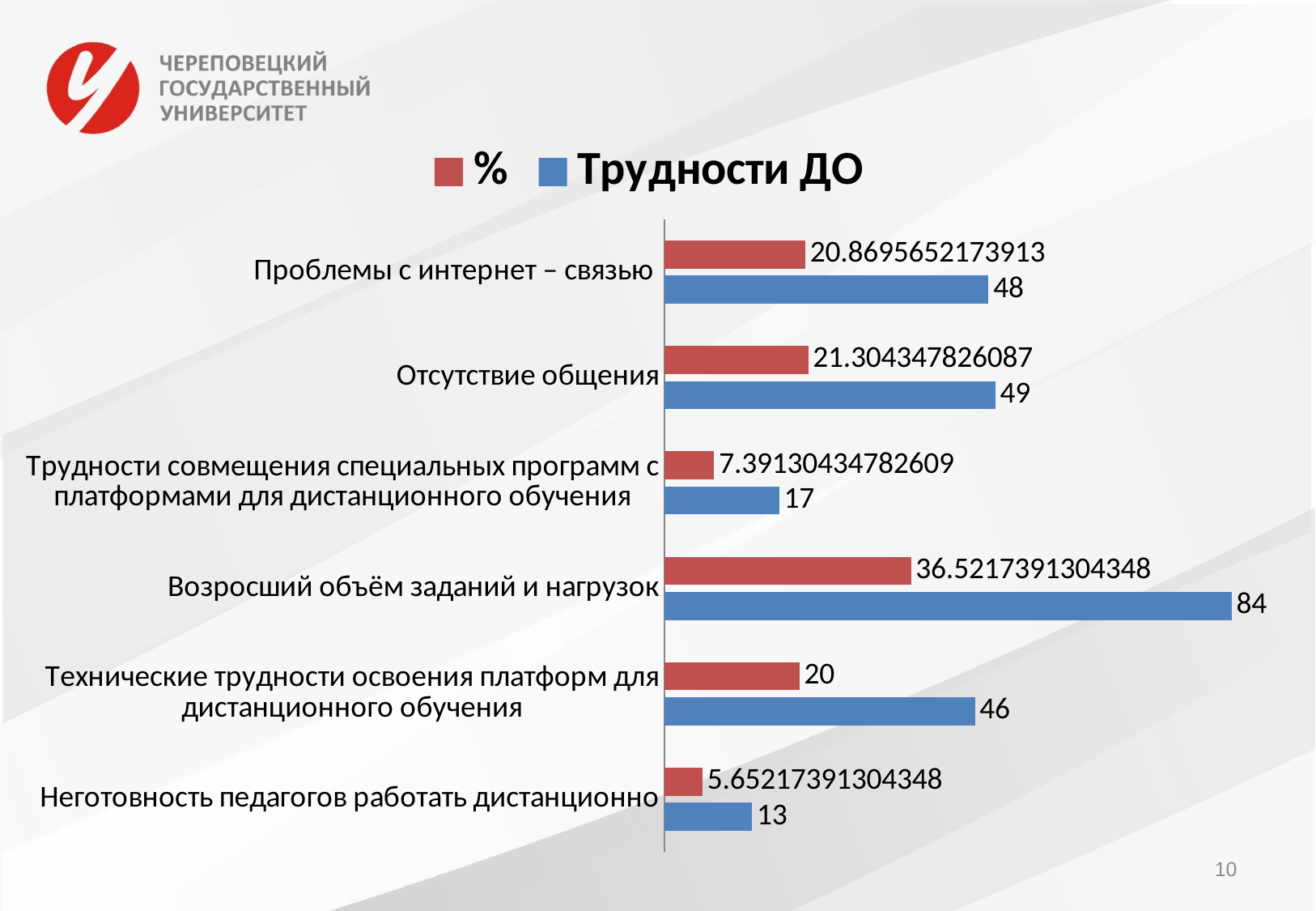
What is the value of the "%" series for "Технические трудности освоения платформ для дистанционного обучения"? 20 What kind of chart is shown on the slide? Bar chart How many series does the legend list? 2 What is the value of the "Трудности ДО" series for "Возросший объём заданий и нагрузок"? 84 What is the difference between the "Трудности ДО" values for "Возросший объём заданий и нагрузок" and "Проблемы с интернет – связью"? 36 Which category has the highest value in the "Трудности ДО" series? Возросший объём заданий и нагрузок Which colour represents the "%" series in the legend? Red What is the value of the "Трудности ДО" series for "Отсутствие общения"? 49 Which is larger in the "Трудности ДО" series: "Технические трудности освоения платформ для дистанционного обучения" or "Трудности совмещения специальных программ с платформами для дистанционного обучения"? Технические трудности освоения платформ для дистанционного обучения What is the value of the "%" series for "Неготовность педагогов работать дистанционно"? 5.65217391304348 Which category has the lowest value in the "Трудности ДО" series? Неготовность педагогов работать дистанционно How many categories are shown on the chart? 6